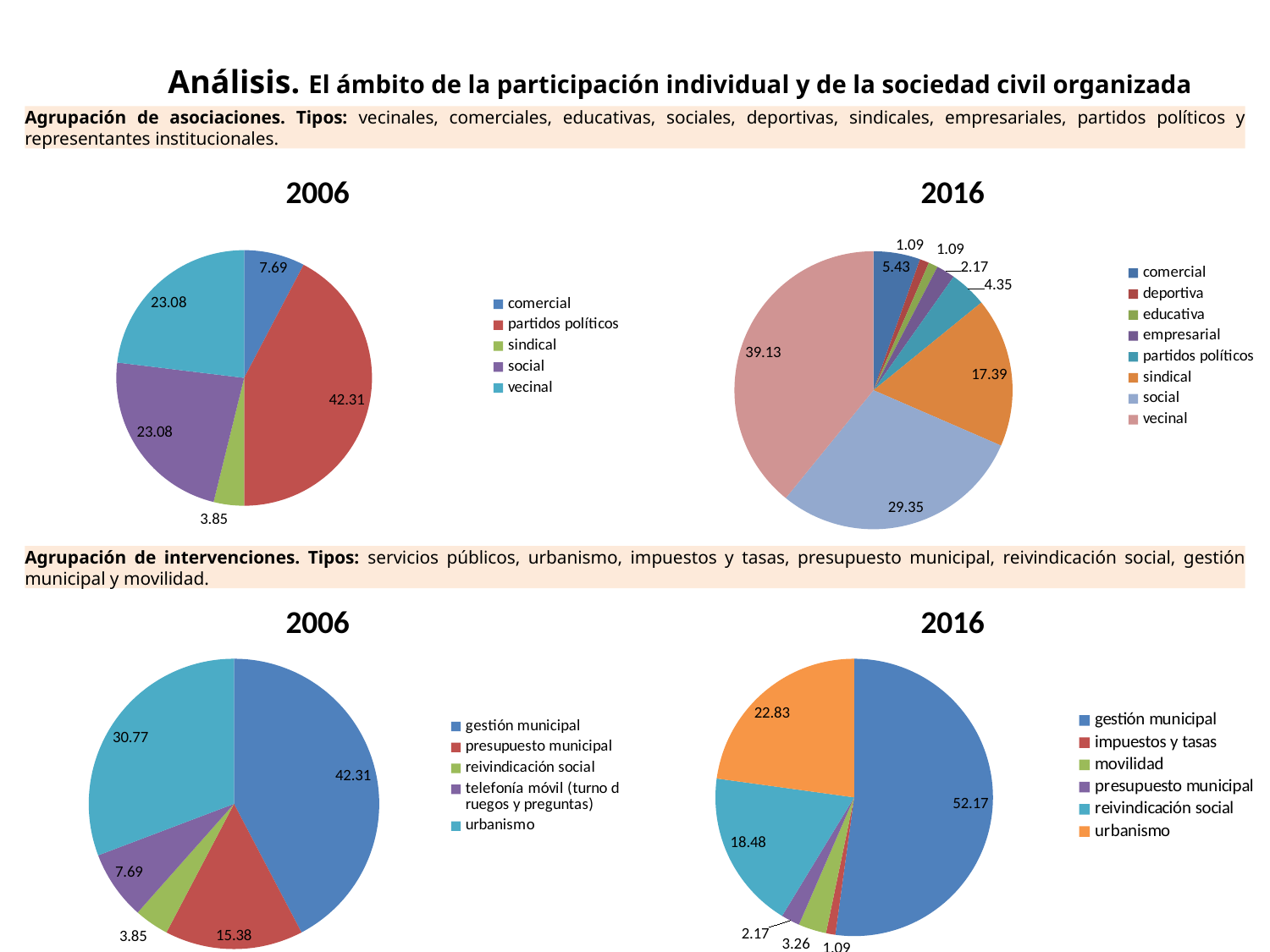
In the top-left pie chart (Agrupación de asociaciones, 2006), which category has the smallest slice? sindical In the bottom-right pie chart (Agrupación de intervenciones, 2016), what is the value for reivindicación social? 18.48 In the bottom-right pie chart (Agrupación de intervenciones, 2016), which category has the smallest slice? impuestos y tasas What type of chart is used for the four charts on the slide? pie chart In the top-right pie chart (Agrupación de asociaciones, 2016), what is the difference between the social and sindical values? 11.96 In the top-left pie chart (Agrupación de asociaciones, 2006), what is the value for partidos políticos? 42.31 In the top-right pie chart (Agrupación de asociaciones, 2016), how many categories does the legend list? 8 In the bottom-left pie chart (Agrupación de intervenciones, 2006), what is the value for urbanismo? 30.77 In the top-right pie chart (Agrupación de asociaciones, 2016), what is the value for vecinal? 39.13 In the top-right pie chart (Agrupación de asociaciones, 2016), which is larger, comercial or partidos políticos? comercial In the bottom-left pie chart (Agrupación de intervenciones, 2006), what is the difference between gestión municipal and presupuesto municipal? 26.93 In the bottom-left pie chart (Agrupación de intervenciones, 2006), which category has the largest slice? gestión municipal